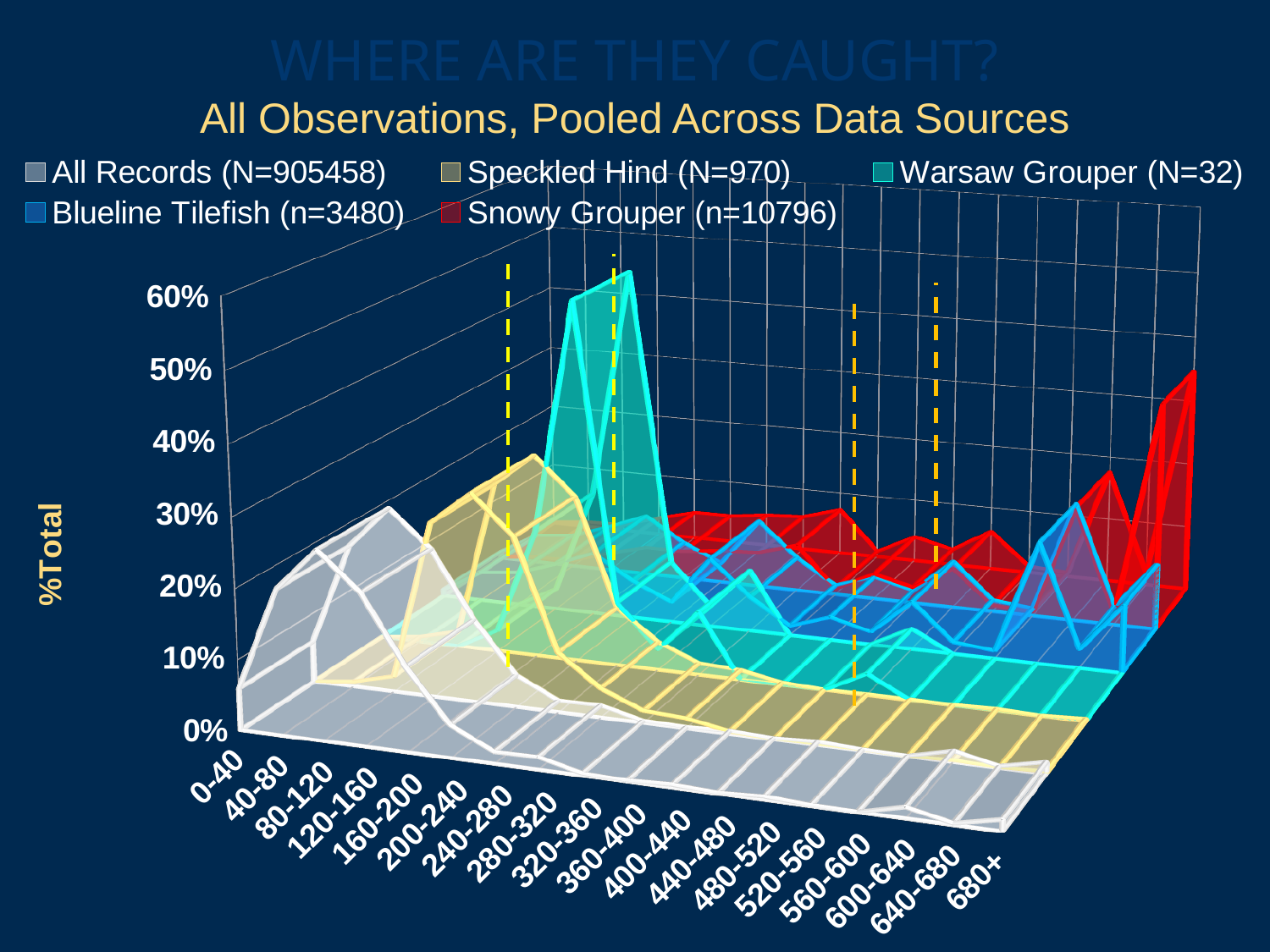
Is the value for Snowy Grouper in the 680+ category greater or less than 20%? greater Do the All Records values rise or fall along the x axis from 160-200 onward? fall How many depth categories are shown along the x axis? 18 What is the label on the vertical axis? %Total What kind of chart is shown on the slide? area chart Which is larger, the peak value for Warsaw Grouper or the peak value for Speckled Hind? Warsaw Grouper What is the last category on the x axis? 680+ Is the value for All Records in the 680+ category greater or less than 10%? less Is the peak value for Warsaw Grouper greater or less than 40%? greater Which series reaches the highest peak value on the chart? Warsaw Grouper How many series does the chart legend list? 5 What is the title of the chart? All Observations, Pooled Across Data Sources